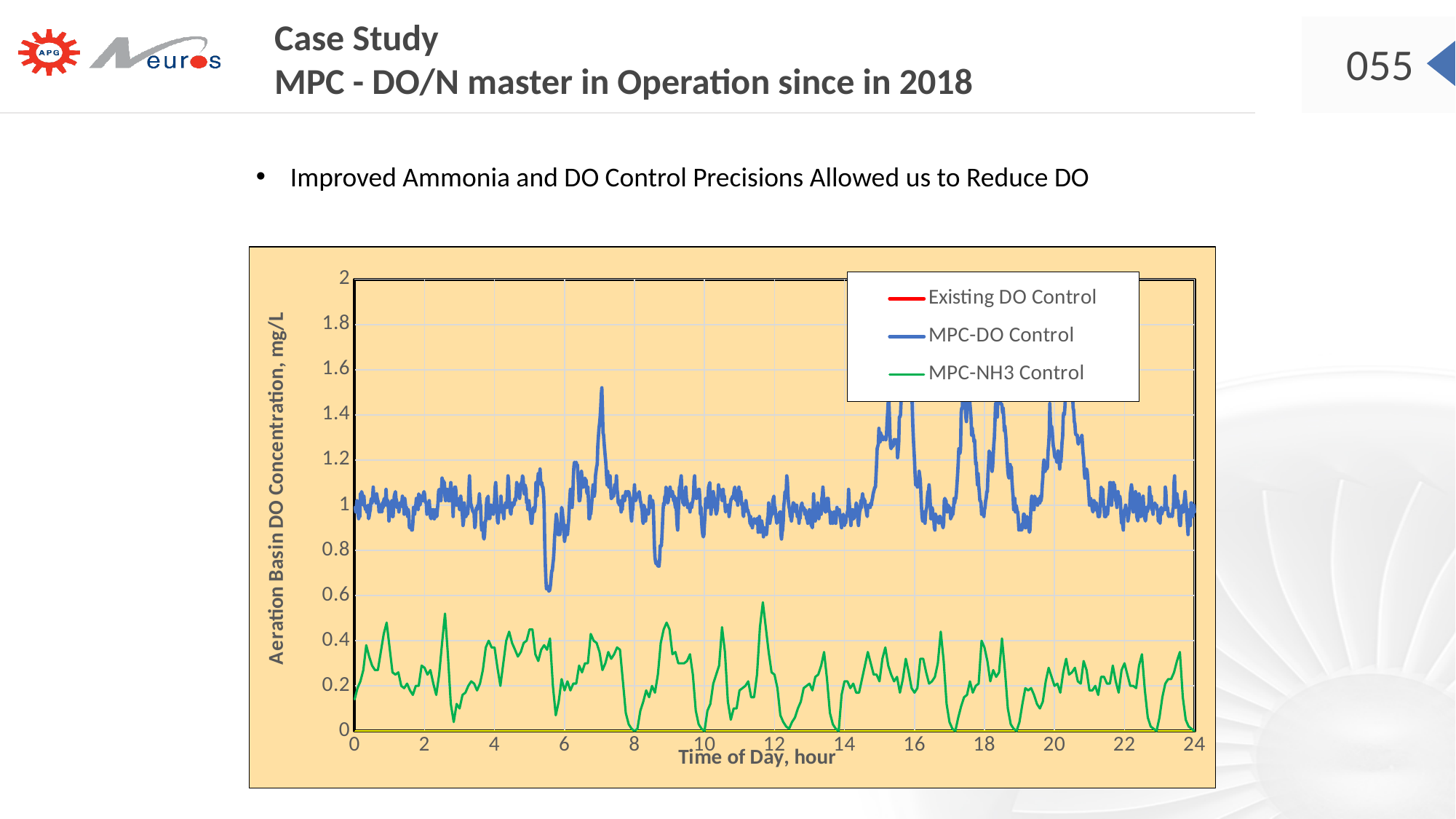
What is the highest tick value shown on the x axis? 24 How many series does the chart legend list? 3 What is the label of the chart's x axis? Time of Day, hour Is the value of MPC-NH3 Control at hour 0 greater or less than 0.4? less What kind of chart is shown on the slide? line chart Is the highest value reached by MPC-NH3 Control greater or less than 0.8? less Which series is plotted higher on the chart, MPC-DO Control or MPC-NH3 Control? MPC-DO Control Is the value of MPC-DO Control at hour 12 greater or less than 0.6? greater What is the label of the chart's y axis? Aeration Basin DO Concentration, mg/L